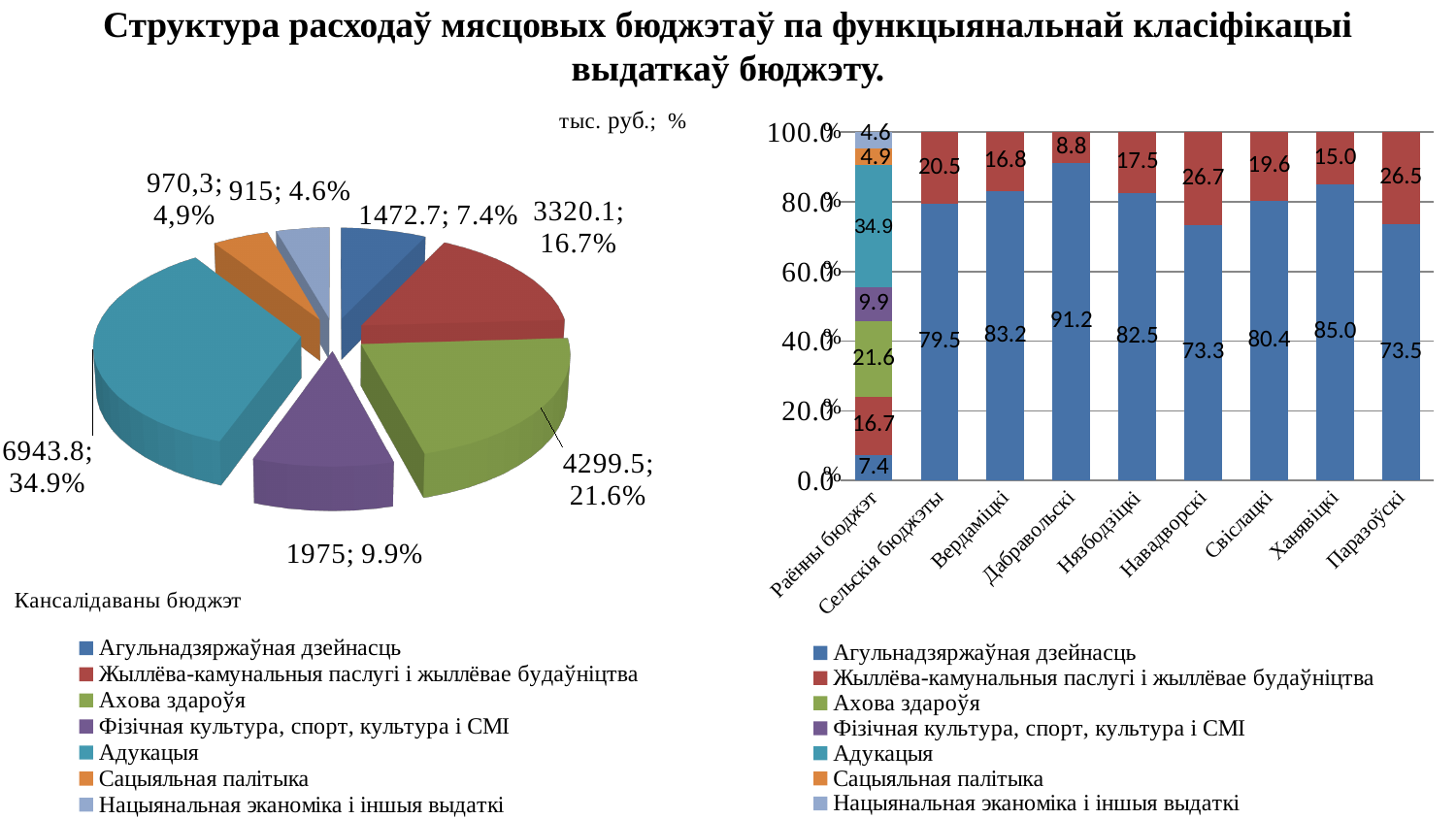
In the pie chart on the left, what value is labelled for the Адукацыя slice? 6943.8; 34.9% How many slices does the pie chart on the left have? 7 In the stacked bar chart on the right, which has the larger red segment (Жыллёва-камунальныя паслугі), Свіслацкі or Ханявіцкі? Свіслацкі In the pie chart on the left, what share of the pie does Ахова здароўя take? 21.6% In the stacked bar chart on the right, what is the value of the blue segment (Агульнадзяржаўная дзейнасць) for Дабравольскі? 91.2 How many series does the legend of the stacked bar chart on the right list? 7 In the pie chart on the left, which category has the smallest slice? Нацыянальная эканоміка і іншыя выдаткі In the stacked bar chart on the right, which budget has the highest value for Агульнадзяржаўная дзейнасць (blue segment)? Дабравольскі In the pie chart on the left, which category has the largest slice? Адукацыя How many budget categories are shown on the x axis of the stacked bar chart on the right? 9 In the stacked bar chart on the right, what is the difference between the blue segment values for Ханявіцкі and Сельскія бюджэты? 5.5 What kind of chart is the chart on the left of the slide? Pie chart